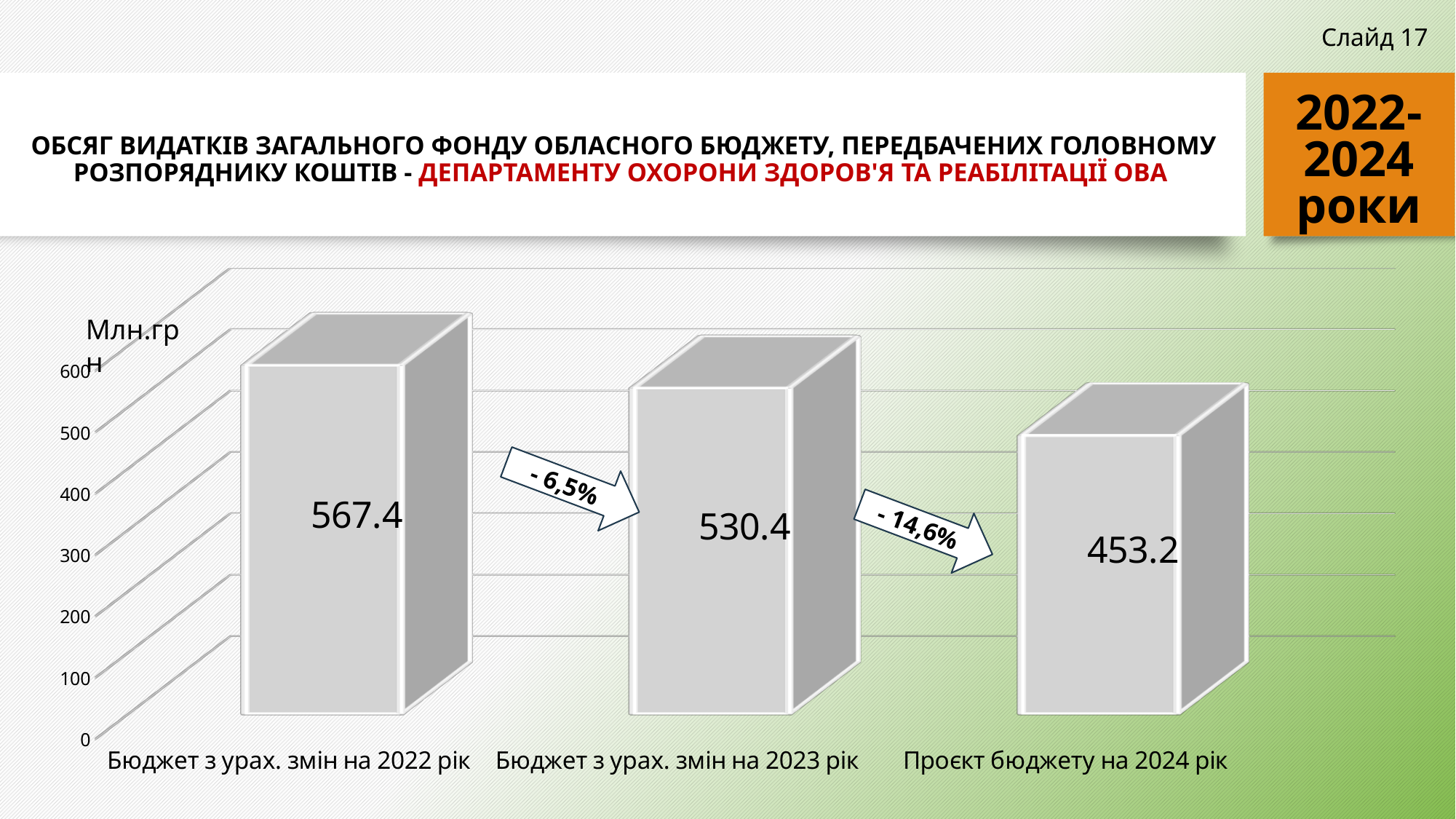
What is the value for "Проєкт бюджету на 2024 рік"? 453.2 What kind of chart is shown on the slide? bar chart Do the values rise or fall from 2022 to 2024? fall What is the value for "Бюджет з урах. змін на 2022 рік"? 567.4 Which is larger, the value for 2023 or the value for 2024? 2023 What is the difference between the values for 2022 and 2023? 37.0 How many categories are shown in the chart? 3 Is the value for "Проєкт бюджету на 2024 рік" greater or less than 500? less What is the value for "Бюджет з урах. змін на 2023 рік"? 530.4 Which category has the lowest value? Проєкт бюджету на 2024 рік Which category has the highest value? Бюджет з урах. змін на 2022 рік What is the difference between the values for 2023 and 2024? 77.2